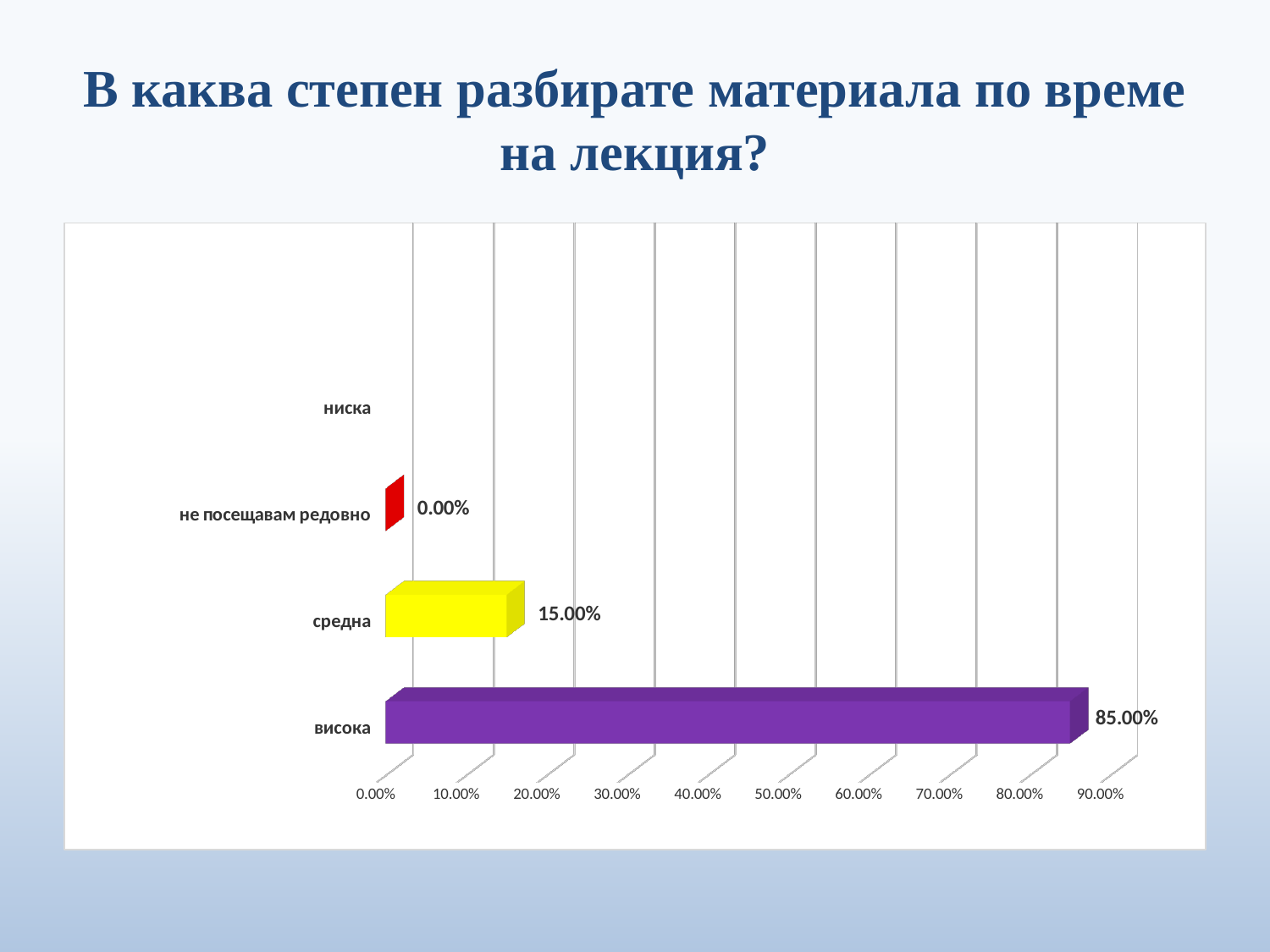
What value is shown for the category "не посещавам редовно"? 0.00% Is the value for "висока" greater or less than 50.00%? greater Is the value for "средна" greater or less than 20.00%? less Which category has the highest value? висока What is the title of the slide above the chart? В каква степен разбирате материала по време на лекция? What value is shown for the category "висока"? 85.00% What kind of chart is shown on the slide? bar chart What colour is the bar for "висока"? purple How many categories are listed on the vertical axis of the chart? 4 What is the difference between the values for "висока" and "средна"? 70.00% What value is shown for the category "средна"? 15.00% Which is larger, the value for "средна" or the value for "не посещавам редовно"? средна